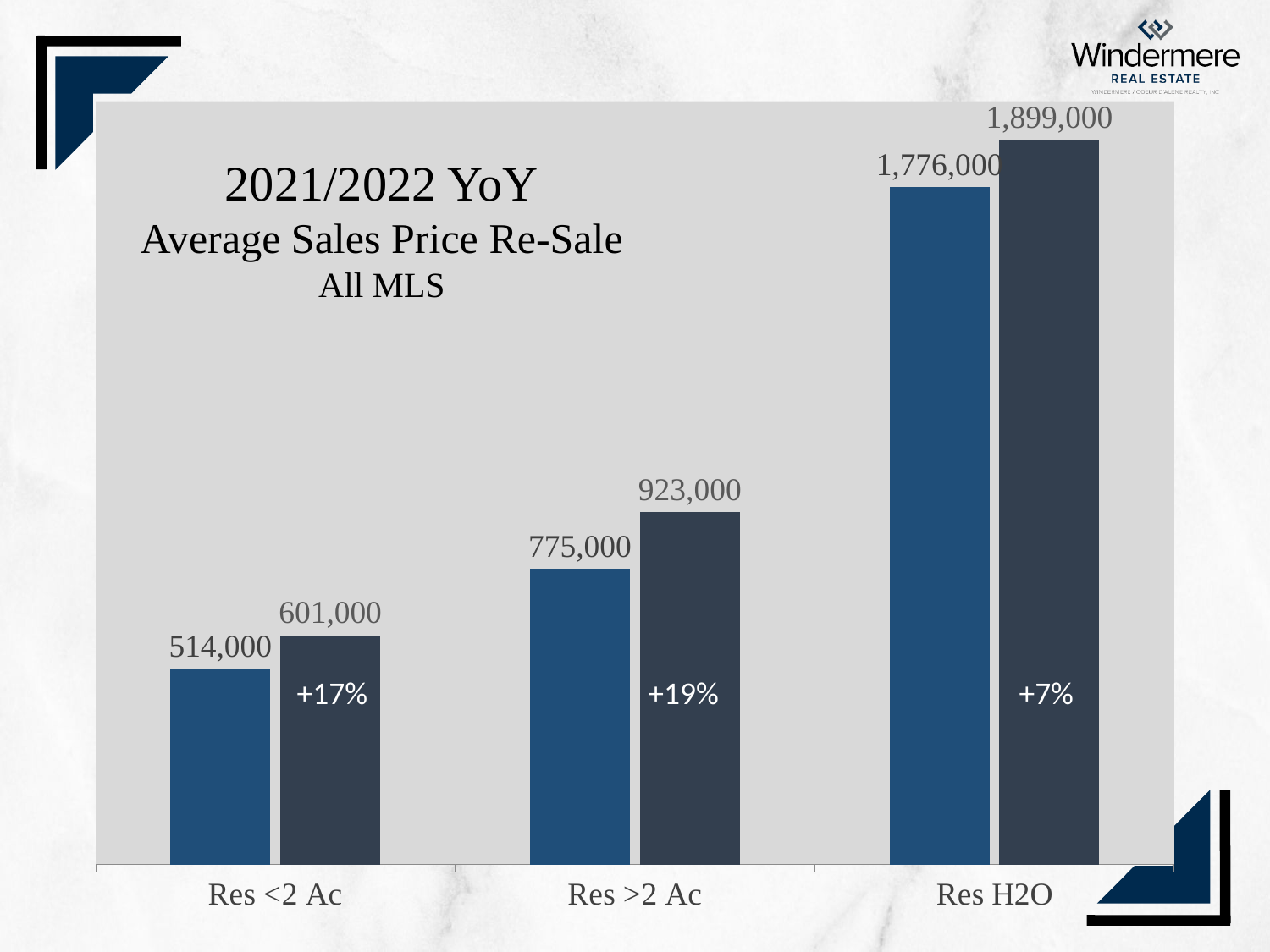
What is the value of the lighter blue (first) bar for Res <2 Ac? 514,000 What percentage change is printed on the darker bar for Res >2 Ac? +19% What is the difference between the two bars for Res >2 Ac? 148,000 What is the value of the darker (second) bar for Res H2O? 1,899,000 Which category has the highest bar on the chart? Res H2O Which is larger: the darker bar for Res <2 Ac or the lighter blue bar for Res >2 Ac? The lighter blue bar for Res >2 Ac How many categories are shown on the x axis? 3 Which category has the lowest bar on the chart? Res <2 Ac What is the difference between the two bars for Res H2O? 123,000 What is the value of the lighter blue (first) bar for Res >2 Ac? 775,000 What kind of chart is shown on the slide? Bar chart What is the value of the darker (second) bar for Res <2 Ac? 601,000